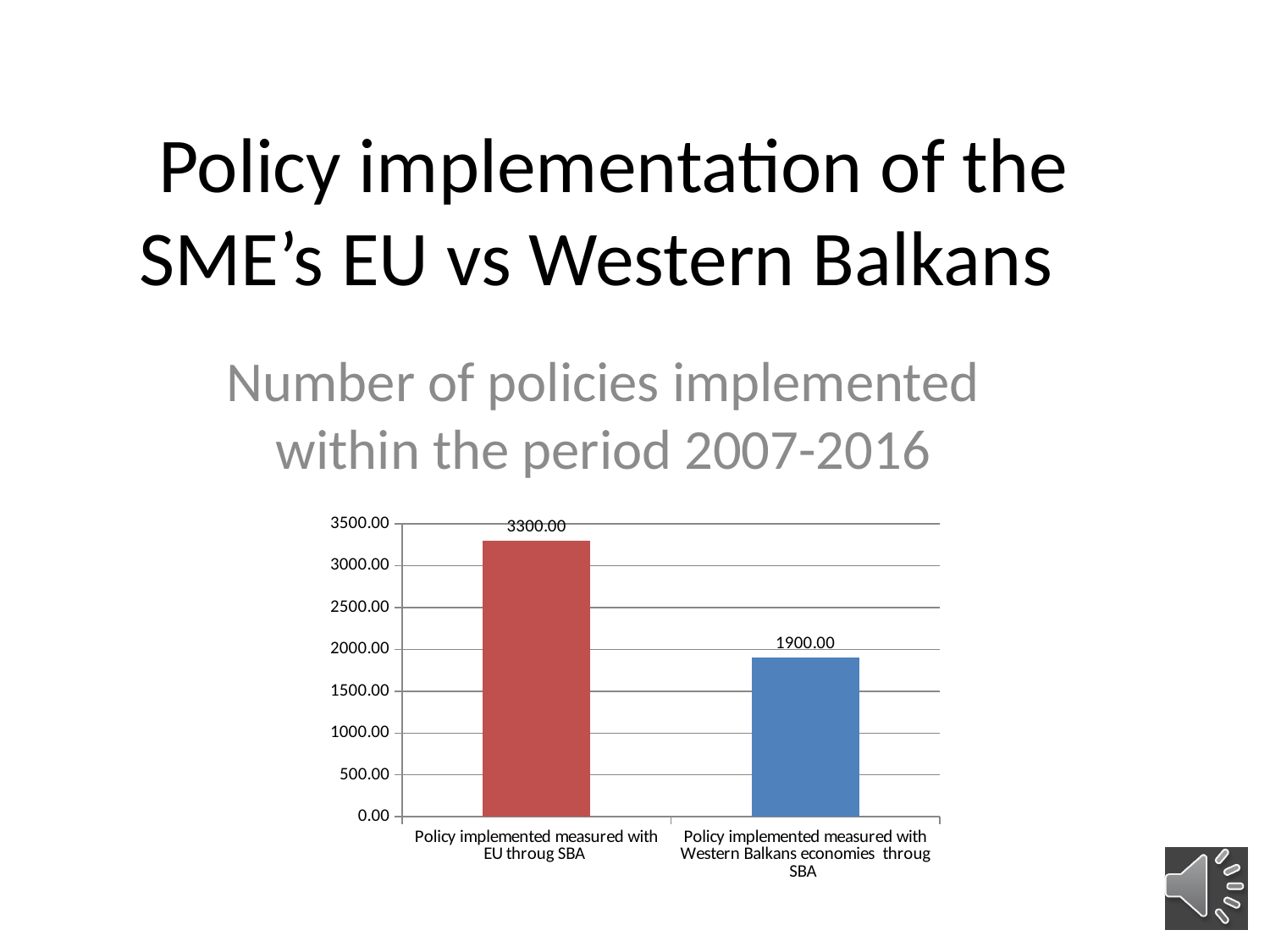
What colour is the bar for 'Policy implemented measured with EU throug SBA'? red Which category has the highest value? Policy implemented measured with EU throug SBA What kind of chart is shown on the slide? bar chart What is the value for 'Policy implemented measured with EU throug SBA'? 3300.00 What is the value for 'Policy implemented measured with Western Balkans economies throug SBA'? 1900.00 Is the value for 'Policy implemented measured with Western Balkans economies throug SBA' greater or less than 2000.00? less Which is larger: the value for EU or the value for Western Balkans economies? EU Is the value for 'Policy implemented measured with EU throug SBA' greater or less than 3000.00? greater What is the difference between the EU value and the Western Balkans value? 1400.00 Which category has the lowest value? Policy implemented measured with Western Balkans economies throug SBA How many categories are shown on the chart? 2 What is the maximum value shown on the vertical axis? 3500.00